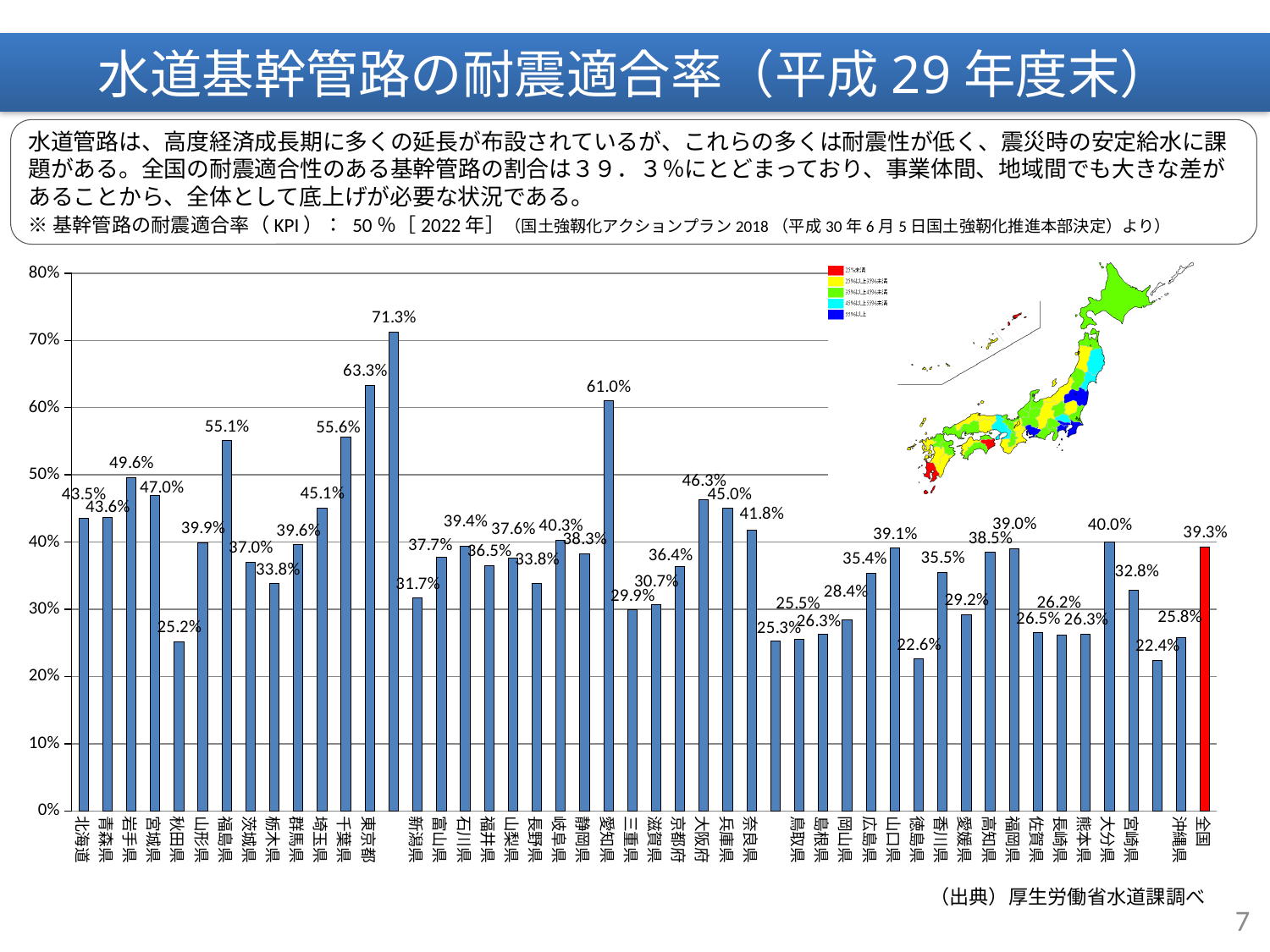
What is the value for 全国 in the chart? 39.3% Which has the larger value, 岩手県 or 宮城県? 岩手県 What kind of chart is shown on the slide? bar chart What is the value for 愛知県 in the chart? 61.0% What colour is the bar for 全国? red What is the difference between the values for 愛知県 and 三重県? 31.1 percentage points What is the difference between the values for 東京都 and 全国? 24.0 percentage points What is the value for 秋田県 in the chart? 25.2% Which has the larger value, 大阪府 or 兵庫県? 大阪府 Is the value for 秋田県 greater or less than 30%? less What is the value for 東京都 in the chart? 63.3% What is the value for 大阪府 in the chart? 46.3%